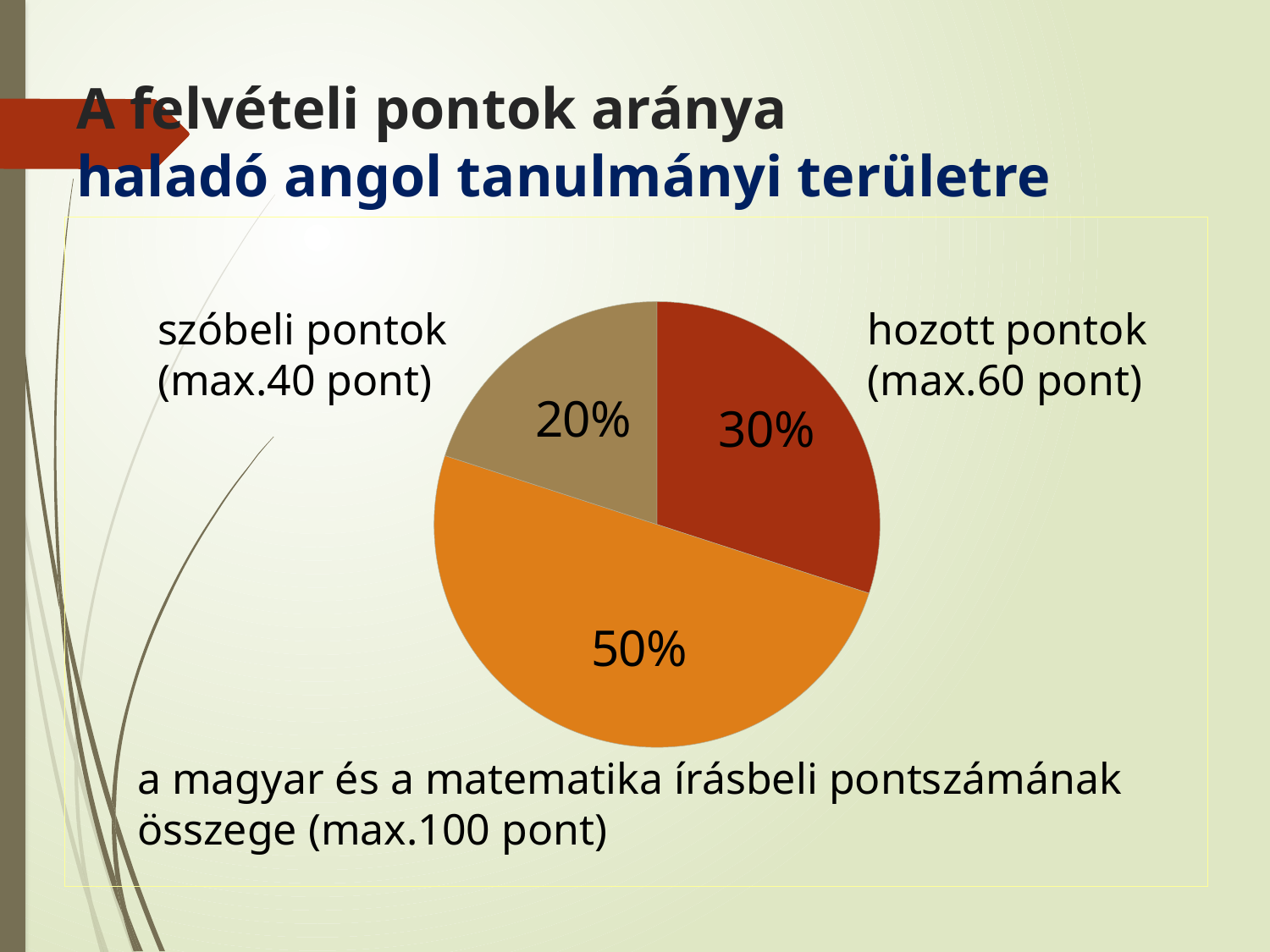
How many slices does the pie chart have? 3 What is the difference in percentage points between the written exam slice (50%) and the 'hozott pontok' slice? 20 percentage points What colour is the slice labelled 50%? orange What share of the pie does the slice labelled 'szóbeli pontok (max.40 pont)' represent? 20% Which slice of the pie is the smallest? szóbeli pontok (max.40 pont) What share of the pie does the slice for 'a magyar és a matematika írásbeli pontszámának összege (max.100 pont)' represent? 50% What share of the pie does the slice labelled 'hozott pontok (max.60 pont)' represent? 30% Which is larger: the 'hozott pontok' slice or the 'szóbeli pontok' slice? hozott pontok Which slice of the pie is the largest? a magyar és a matematika írásbeli pontszámának összege (max.100 pont) What kind of chart is shown on the slide? pie chart What is the difference in percentage points between the 'hozott pontok' slice and the 'szóbeli pontok' slice? 10 percentage points What is the title of the slide containing the pie chart? A felvételi pontok aránya haladó angol tanulmányi területre